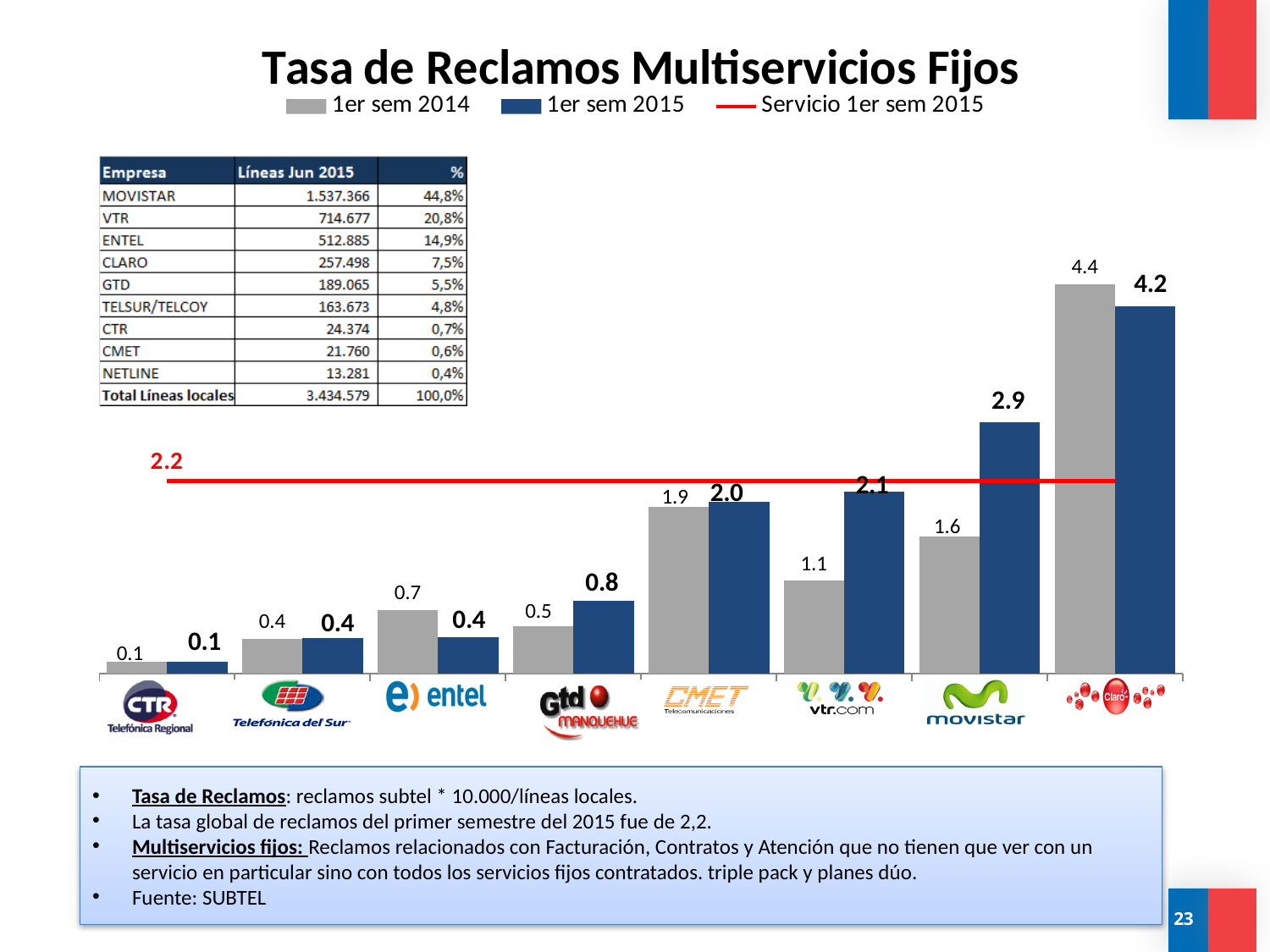
What kind of chart is shown on the slide? Combination bar and line chart How many series does the legend list? 3 What is the title of the chart? Tasa de Reclamos Multiservicios Fijos What is the value for Claro in the 1er sem 2015 series? 4.2 Which company has the highest value in the 1er sem 2015 series? Claro Which company has the lowest value in the 1er sem 2014 series? CTR How many companies are shown on the x axis of the chart? 8 What is the value for Movistar in the 1er sem 2014 series? 1.6 What value does the red 'Servicio 1er sem 2015' line mark? 2.2 What is the value for VTR in the 1er sem 2015 series? 2.1 Which is larger for Entel: the 1er sem 2014 value or the 1er sem 2015 value? 1er sem 2014 What is the difference between the 1er sem 2015 and 1er sem 2014 values for Movistar? 1.3